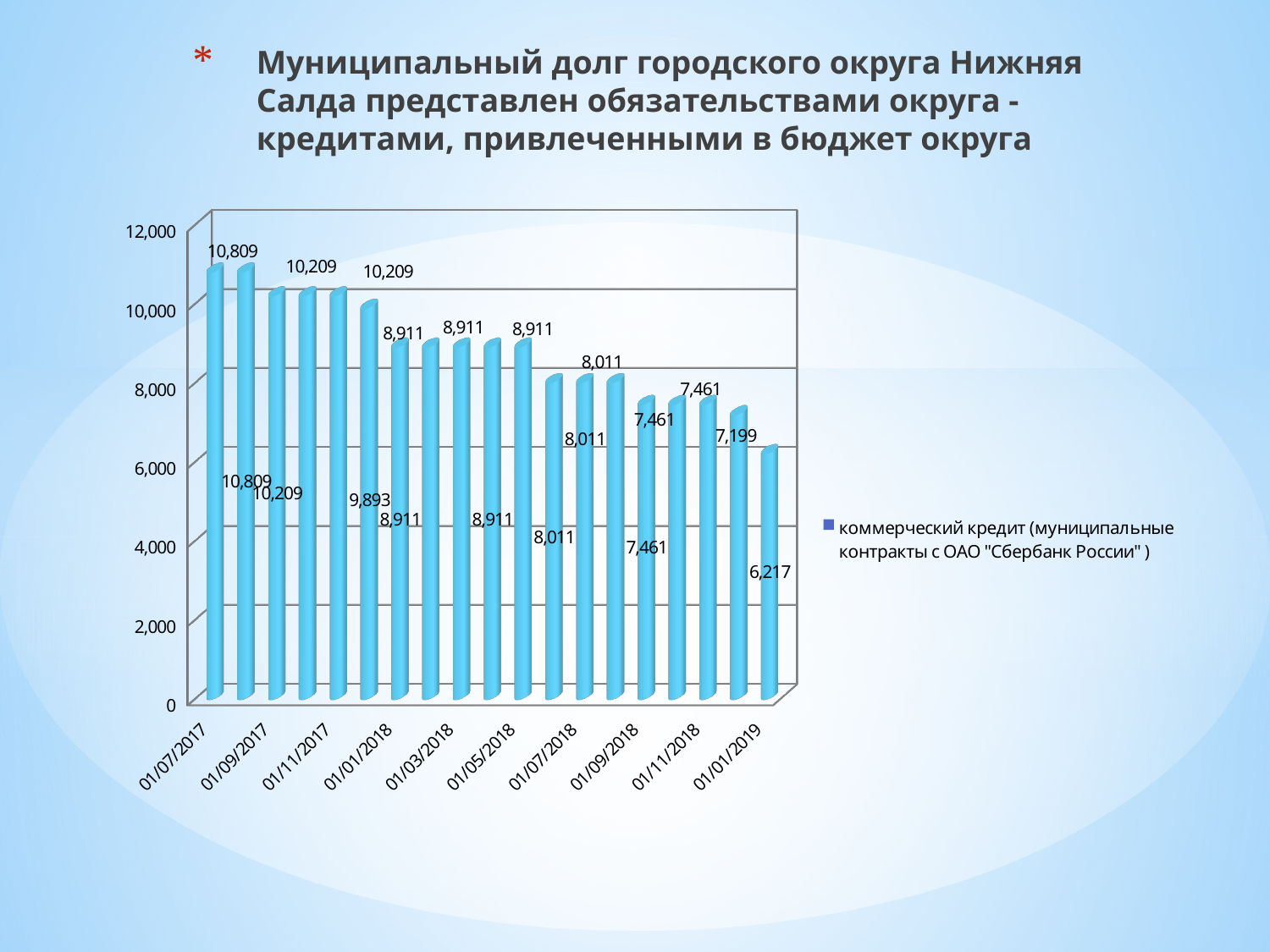
How many date labels are shown on the x axis? 10 Which is larger, the value for 01/07/2017 or the value for 01/01/2019? 01/07/2017 What type of chart is shown on the slide? bar chart What is the difference between the values for 01/07/2017 and 01/01/2019? 4,592 Which date has the lowest value in the chart? 01/01/2019 What is the value of the bar for 01/01/2019? 6,217 What is the value of the bar for 01/07/2017? 10,809 Is the value for 01/09/2018 greater or less than 8,000? less Which date has the highest value in the chart? 01/07/2017 How many series does the legend list? 1 Do the values generally rise or fall from left to right along the x axis? fall Is the value for 01/01/2018 greater or less than 10,000? less